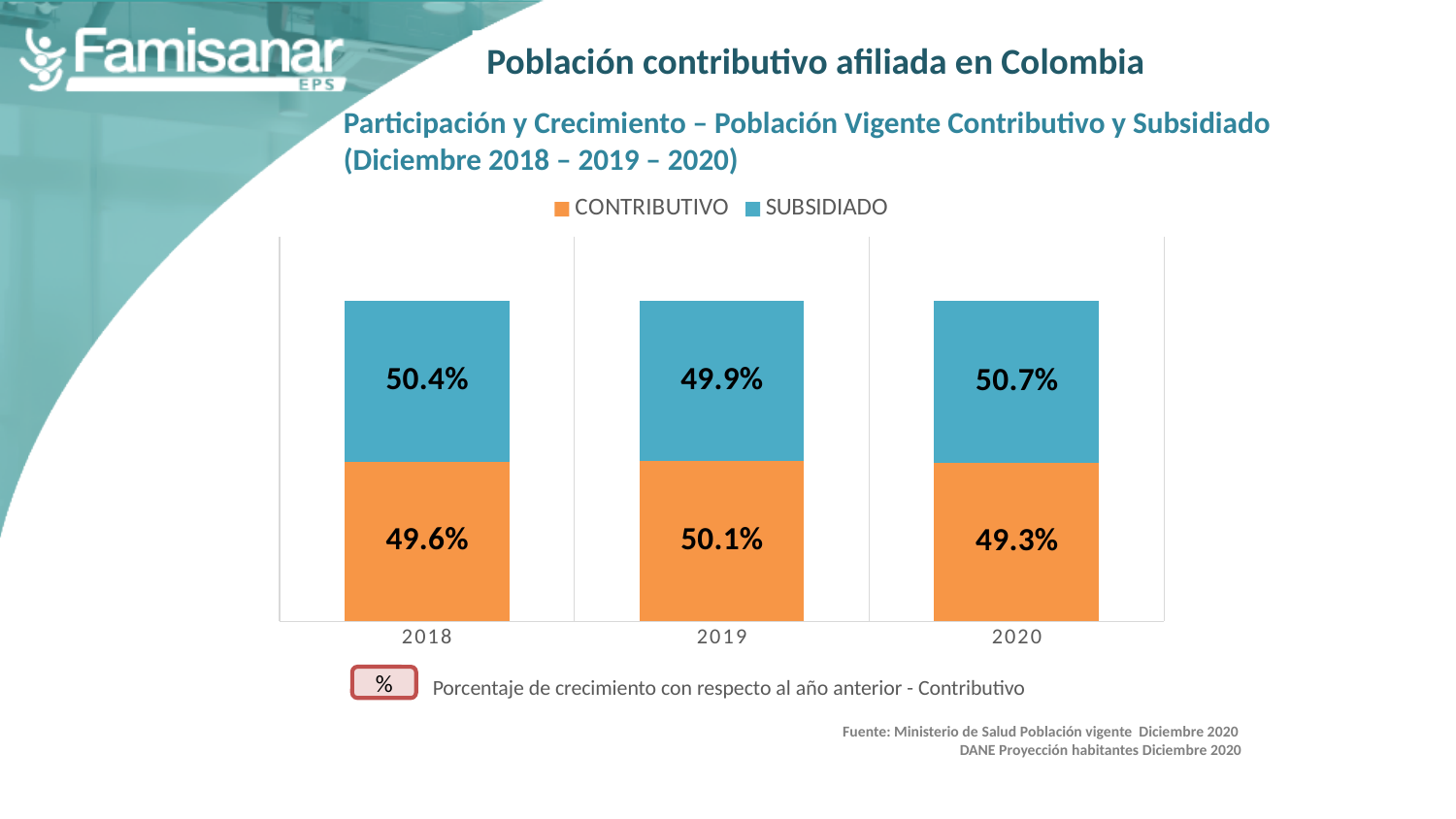
What is the CONTRIBUTIVO value for 2019? 50.1% In which year is the CONTRIBUTIVO value highest? 2019 In 2018, which is larger, CONTRIBUTIVO or SUBSIDIADO? SUBSIDIADO What kind of chart is shown on the slide? Stacked bar chart What is the SUBSIDIADO value for 2019? 49.9% Which colour represents CONTRIBUTIVO in the chart? Orange In which year is the SUBSIDIADO value lowest? 2019 How many series does the legend list? 2 What is the SUBSIDIADO value for 2020? 50.7% What is the CONTRIBUTIVO value for 2018? 49.6% What is the difference between the SUBSIDIADO and CONTRIBUTIVO values in 2020? 1.4% How many years are shown on the x axis? 3